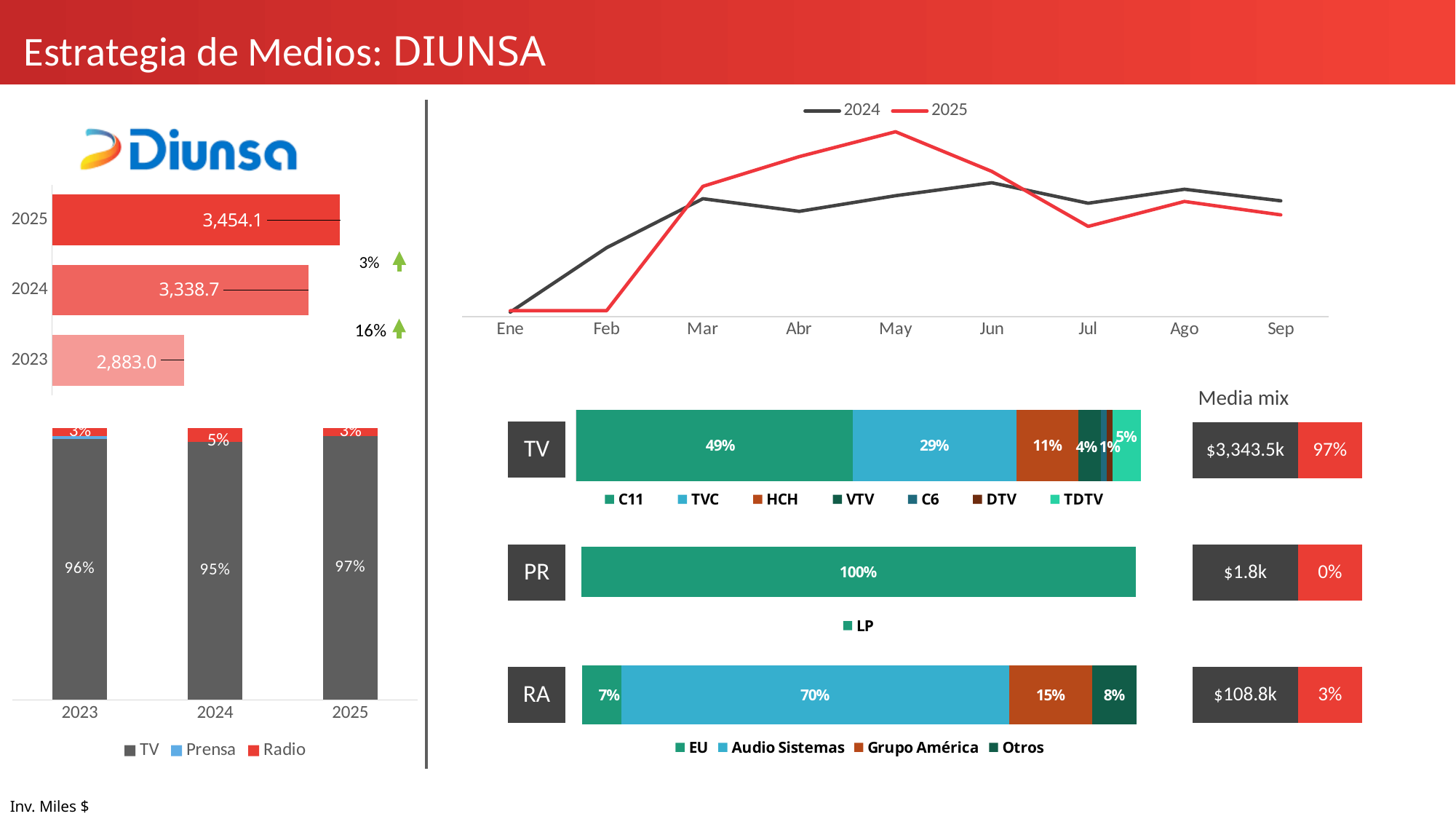
In the horizontal bar chart on the left, what is the value for 2023? 2,883.0 How many series does the legend of the stacked bar chart at the bottom left list? 3 In the line chart at the top right, which series is higher in May, 2024 or 2025? 2025 How many series does the legend of the line chart at the top right list? 2 In the stacked bar chart at the bottom left, what is the TV share for 2024? 95% In the TV media mix bar, what share does C11 have? 49% In the stacked bar chart at the bottom left, what is the Radio share for 2024? 5% In the RA media mix bar, what share does Audio Sistemas have? 70% In the horizontal bar chart on the left, what is the difference between the 2025 and 2024 values? 115.4 How many months are shown on the x axis of the line chart at the top right? 9 In the horizontal bar chart on the left, which year has the highest value? 2025 In the horizontal bar chart on the left, what is the value for 2025? 3,454.1